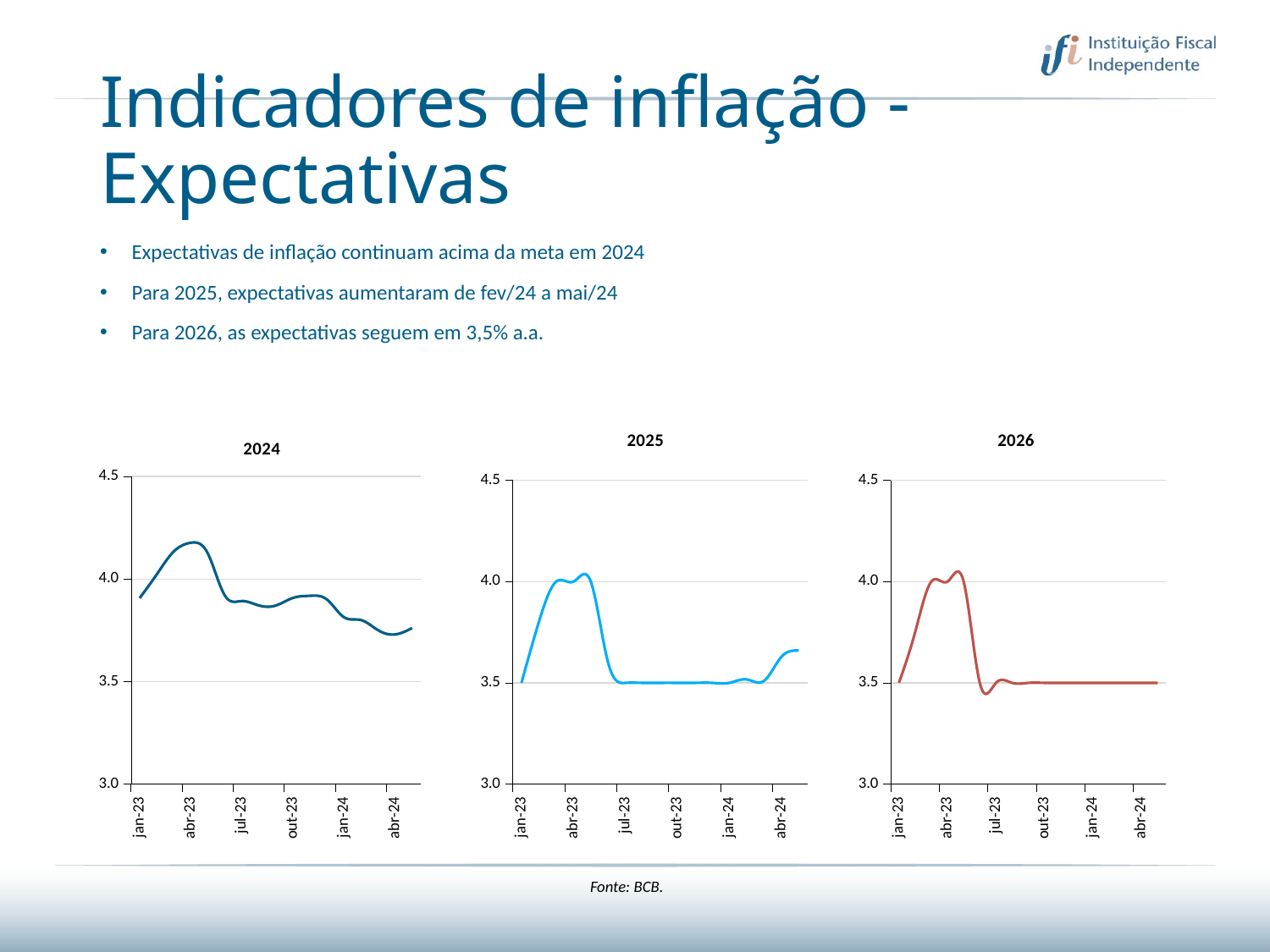
In the chart titled 2024, does the line rise or fall from abr-23 to abr-24? fall What kind of chart is the chart titled 2024? line chart How many month labels are shown on the x axis of the chart titled 2025? 6 In the chart titled 2026, is the value at jan-24 greater or less than 4.0? less What colour is the line in the chart titled 2026? red In the chart titled 2025, is the value at out-23 greater or less than 4.0? less In the chart titled 2024, which labelled month on the x axis has the highest value, abr-23 or abr-24? abr-23 In the chart titled 2024, is the value at abr-24 greater or less than 4.0? less What is the title of the rightmost chart on the slide? 2026